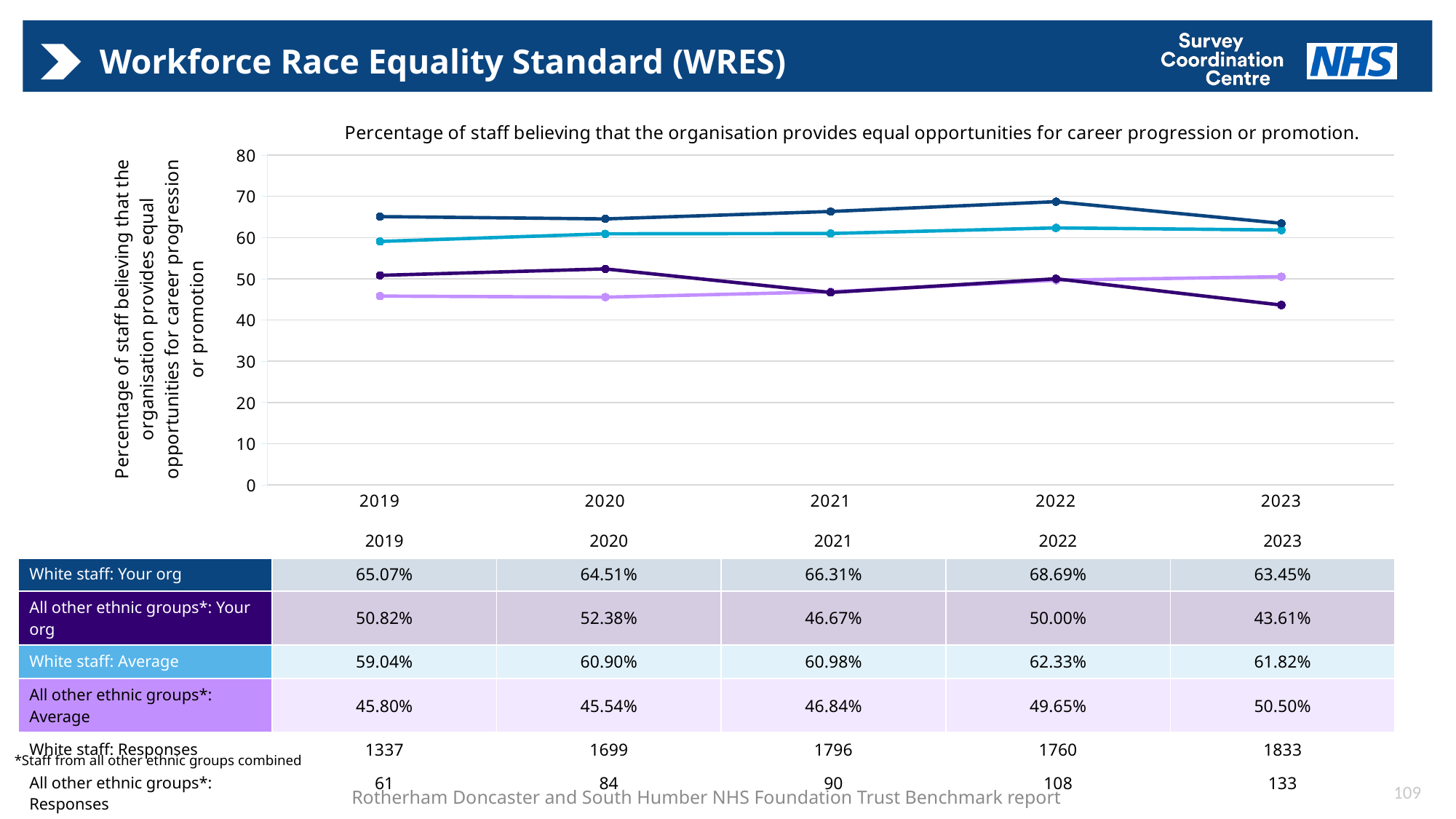
In which year is the value for All other ethnic groups*: Your org lowest? 2023 What is the value for White staff: Average in 2020? 60.90% What is the value for White staff: Your org in 2022? 68.69% What is the value for All other ethnic groups*: Your org in 2023? 43.61% How many years are plotted on the x axis? 5 Which is larger in 2023: All other ethnic groups*: Your org or All other ethnic groups*: Average? All other ethnic groups*: Average In which year is the value for White staff: Your org highest? 2022 What is the difference between White staff: Your org and All other ethnic groups*: Your org in 2023? 19.84% Does the value for All other ethnic groups*: Average rise or fall from 2020 to 2023? rise What is the value for All other ethnic groups*: Average in 2019? 45.80% What type of chart is shown on the slide? line chart Is the value for White staff: Your org in 2021 greater or less than 60? greater